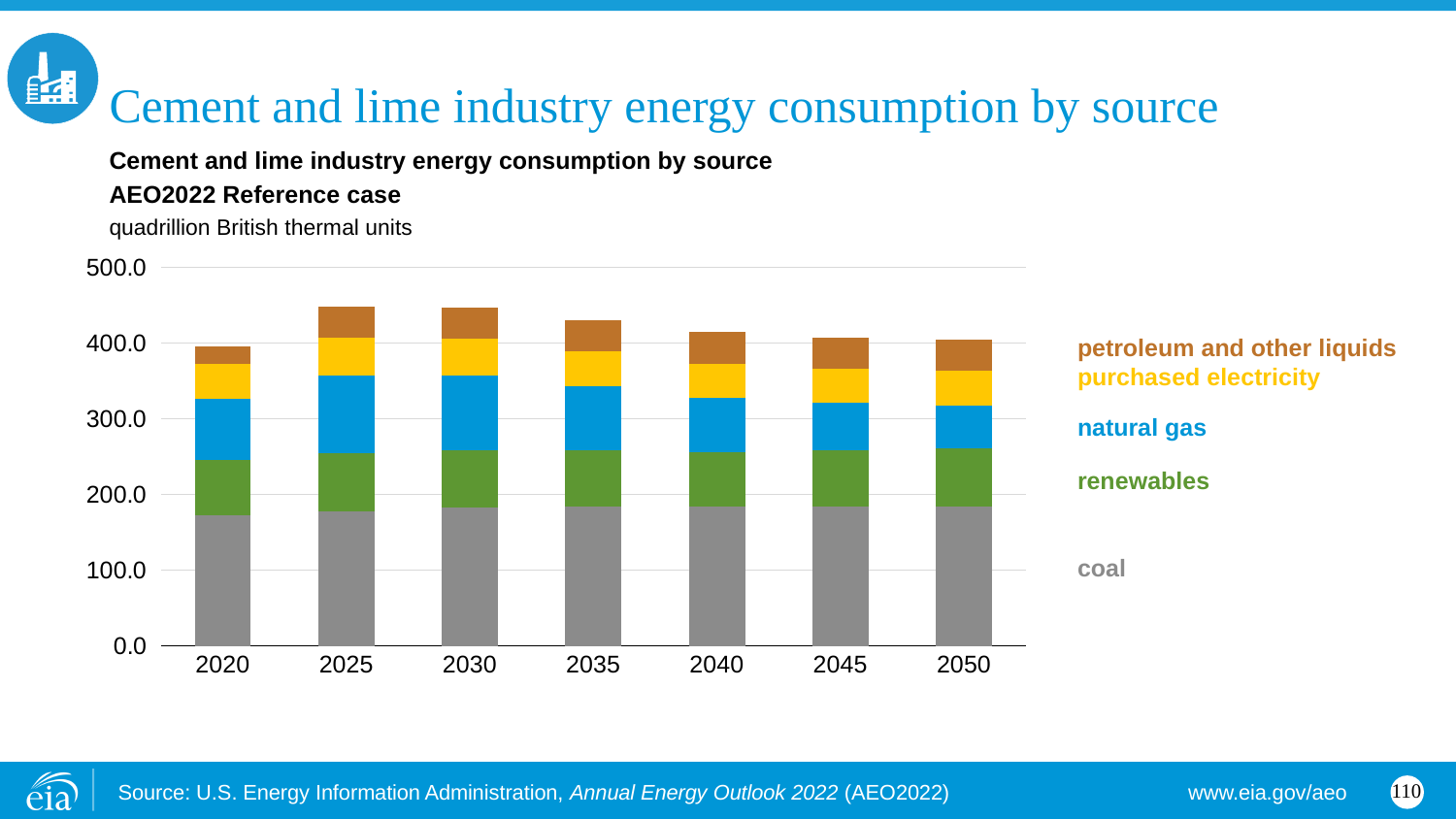
How many energy sources (series) does the legend list? 5 Which year has the larger total energy consumption, 2035 or 2050? 2035 Which energy source forms the bottom segment of each stacked bar? coal Which year has the larger total energy consumption, 2020 or 2025? 2025 What kind of chart is shown on the slide? stacked bar chart Is the coal consumption in 2020 greater or less than 200? less Is the total energy consumption for 2025 greater or less than 400? greater What unit is the y axis measured in? quadrillion British thermal units Is the total energy consumption for 2035 greater or less than 400? greater Do the total bar heights rise or fall from 2025 to 2050? fall How many years (bars) are shown on the x axis? 7